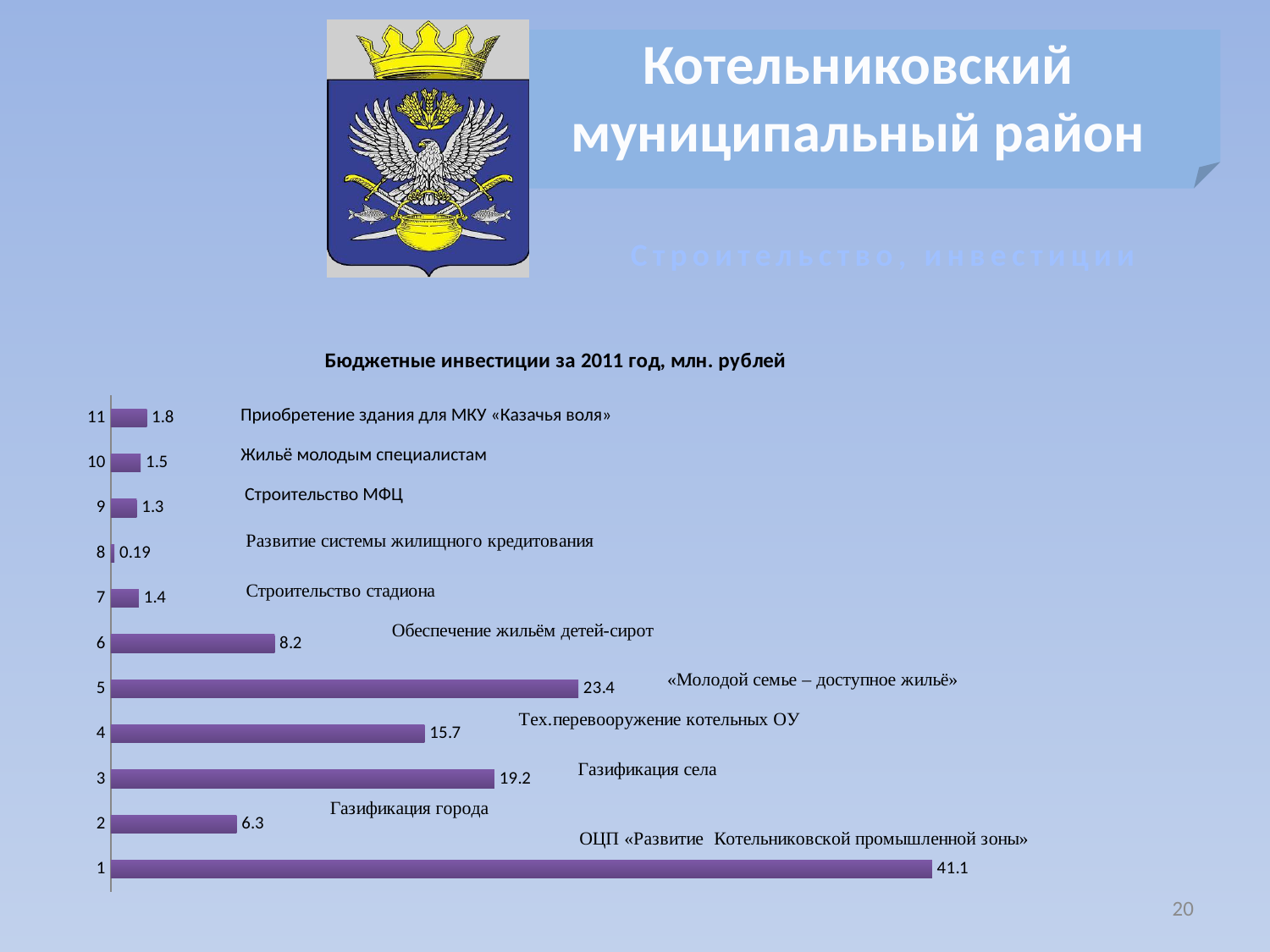
What is the title of the chart? Бюджетные инвестиции за 2011 год, млн. рублей What is the value for category 8 (Развитие системы жилищного кредитования)? 0.19 What is the difference between the values for category 1 and category 5? 17.7 What kind of chart is shown on the slide? Bar chart Which category has the highest value in the chart? 1 What is the value for category 3 (Газификация села)? 19.2 What is the value for category 1 (ОЦП «Развитие Котельниковской промышленной зоны») in the chart? 41.1 Which category has the lowest value in the chart? 8 Which is larger, the value for category 4 (Тех.перевооружение котельных ОУ) or category 6 (Обеспечение жильём детей-сирот)? Category 4 What is the difference between the values for category 3 (Газификация села) and category 2 (Газификация города)? 12.9 How many categories are plotted in the chart? 11 What is the value for category 5 («Молодой семье – доступное жильё»)? 23.4